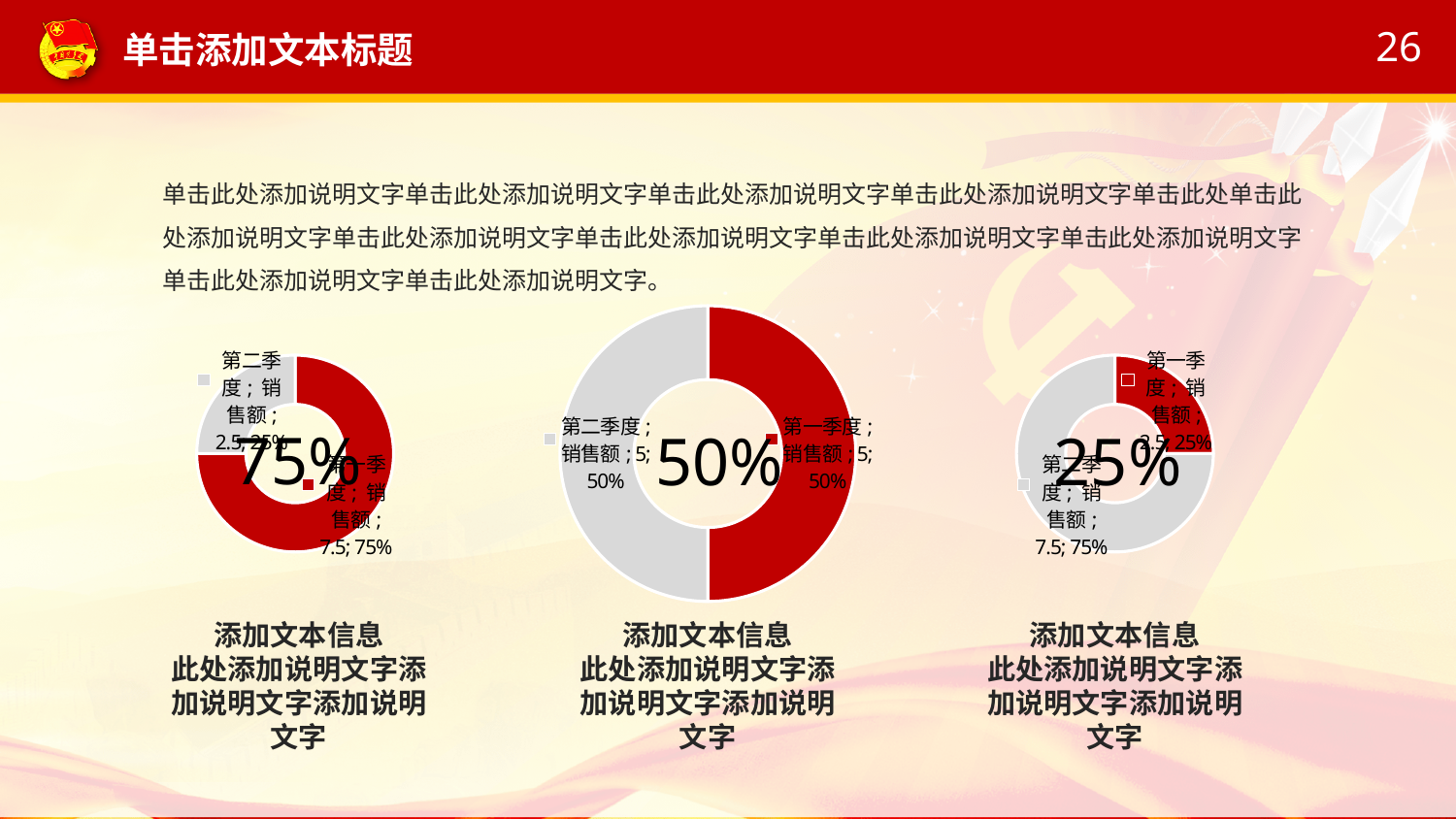
In the left chart, what share does 第一季度 销售额 have? 75% In the right chart, what share does 第一季度 销售额 have? 25% How many slices does the middle chart have? 2 What kind of chart is the left chart on the slide? doughnut chart In the right chart, what is the difference between the values for 第二季度 销售额 and 第一季度 销售额? 5 In the left chart, what is the value for 第二季度 销售额? 2.5 In the right chart, which category has the smaller share? 第一季度 销售额 In the middle chart, what share does 第二季度 销售额 have? 50% In the middle chart, what is the value for 第一季度 销售额? 5 In the left chart, which category has the larger share? 第一季度 销售额 In the right chart, what is the value for 第二季度 销售额? 7.5 What large percentage is displayed in the centre of the middle chart? 50%